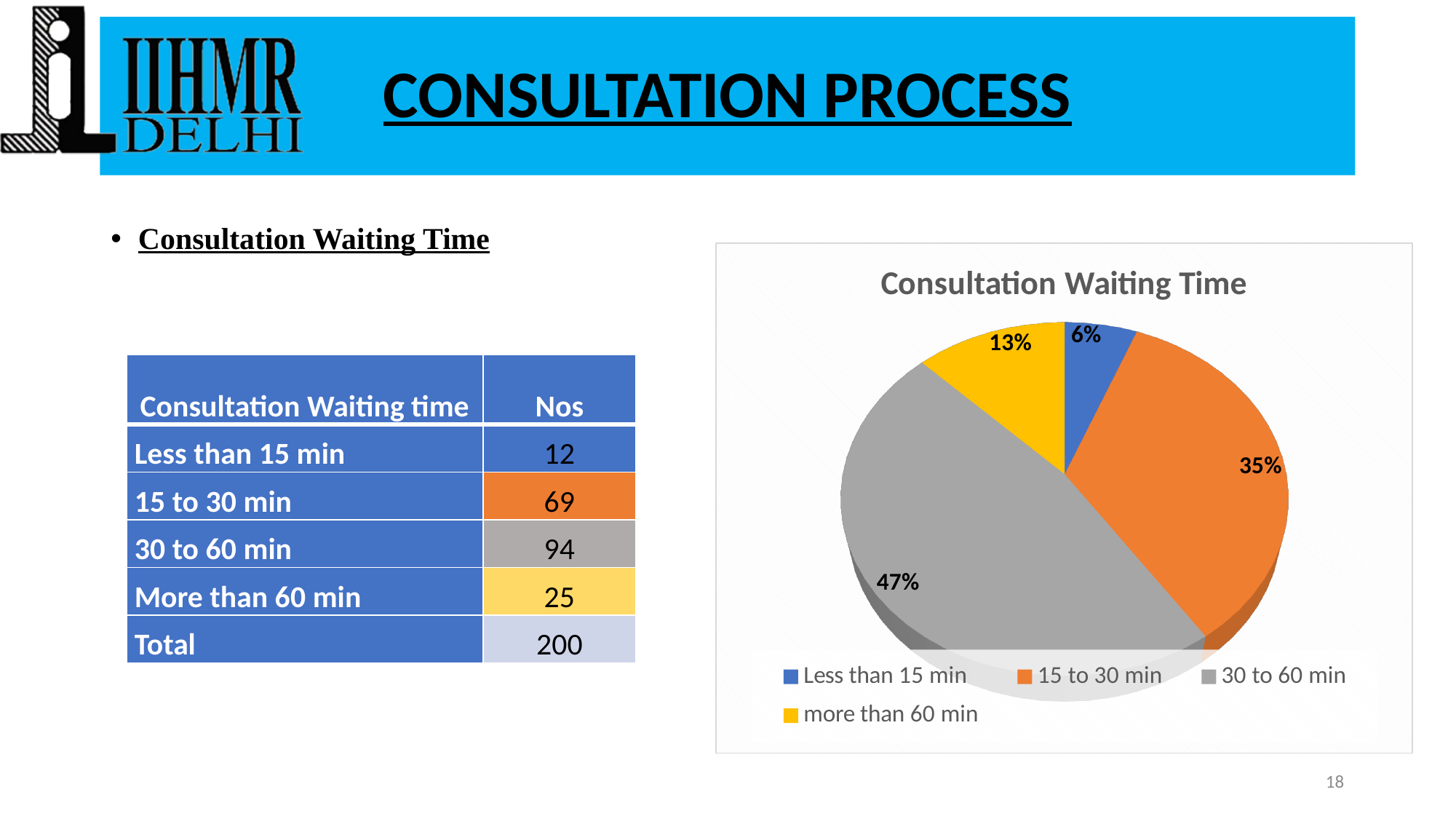
Which category has the smallest slice of the pie? Less than 15 min What is the title of the chart? Consultation Waiting Time How many categories does the pie chart show? 4 What is the difference in percentage points between the '30 to 60 min' slice and the '15 to 30 min' slice? 12% Which slice is larger, 'more than 60 min' or 'Less than 15 min'? more than 60 min Which category has the largest slice of the pie? 30 to 60 min What percentage of the pie does the '30 to 60 min' slice represent? 47% What percentage of the pie does the 'Less than 15 min' slice represent? 6% What percentage of the pie does the 'more than 60 min' slice represent? 13% What colour is the '15 to 30 min' slice in the pie chart? orange What type of chart is shown on the slide? pie chart